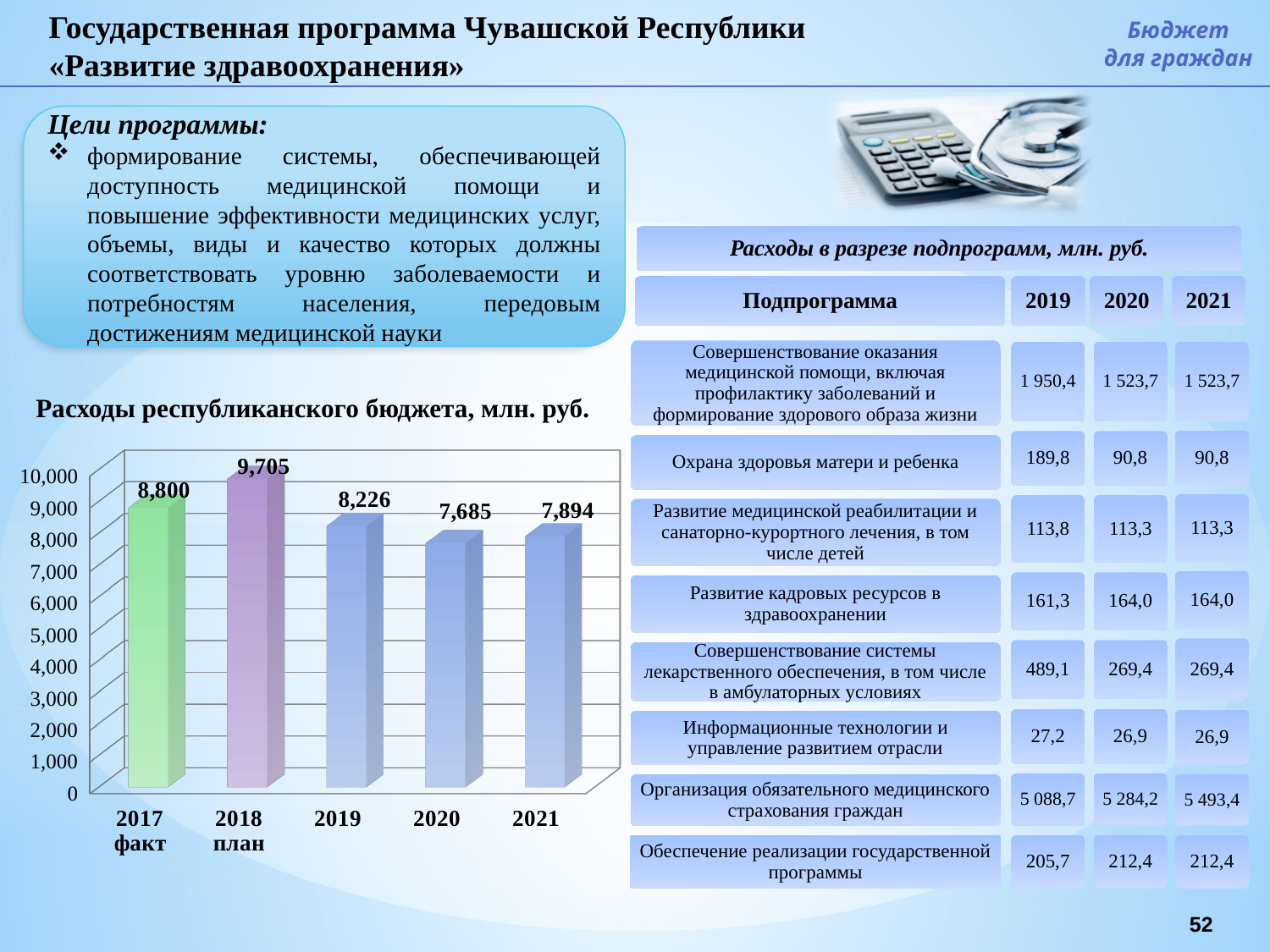
What is the title of the chart on the slide? Расходы республиканского бюджета, млн. руб. Which year has the lowest value in the chart? 2020 Is the value for 2017 факт greater or less than 8,000? greater Which is larger, the value for 2019 or the value for 2021? 2019 What kind of chart is shown on the slide? bar chart Which year has the highest value in the chart? 2018 план How many bars are shown in the chart? 5 What is the value for 2021 in the chart? 7,894 What is the difference between the values for 2018 план and 2019? 1,479 What is the value for 2018 план in the chart? 9,705 What is the value for 2020 in the chart? 7,685 What is the value for 2017 факт in the chart 'Расходы республиканского бюджета, млн. руб.'? 8,800